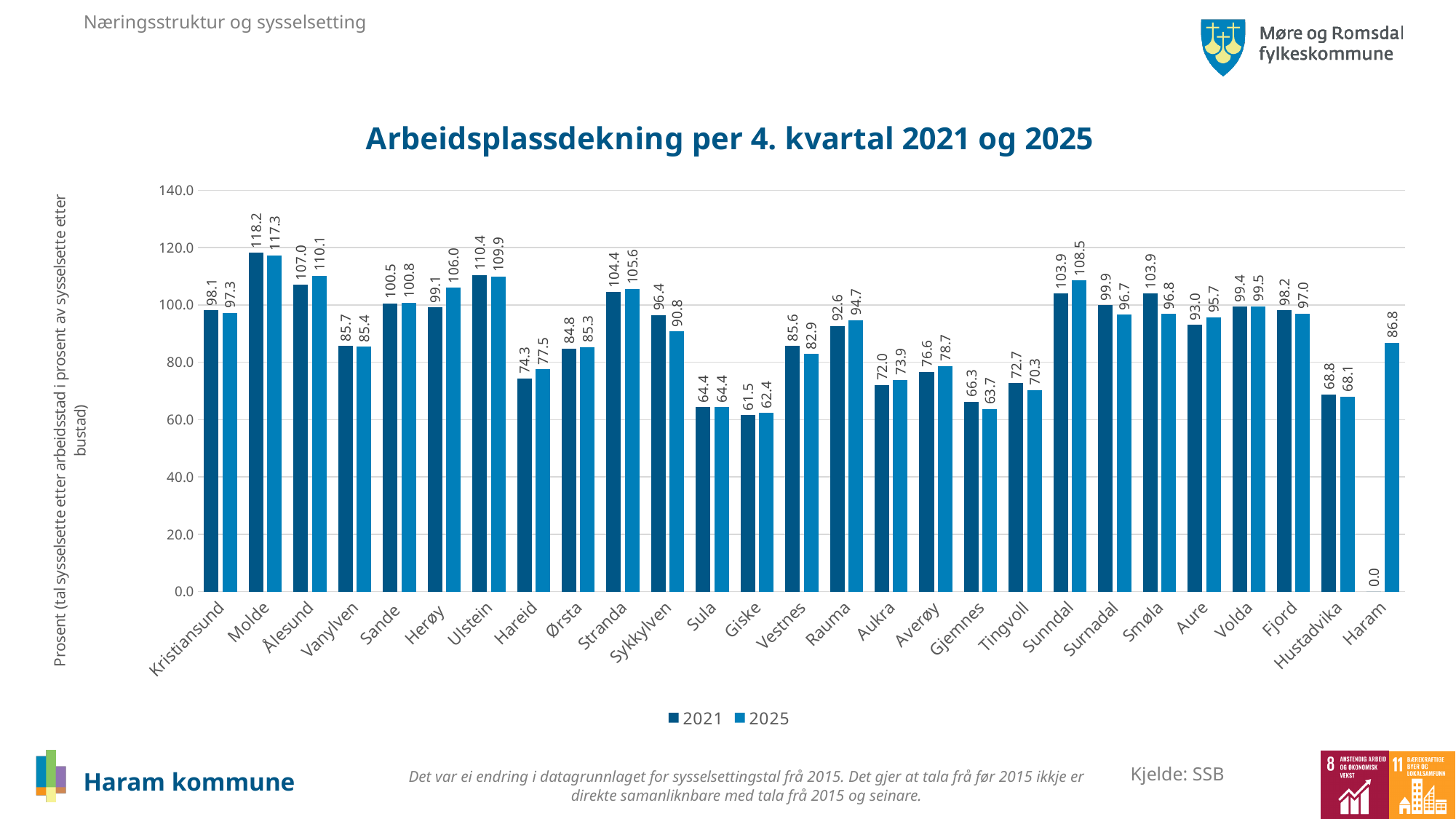
Which municipality has the highest 2025 value? Molde How many municipalities are shown on the x axis? 27 How many series does the legend list? 2 What is the 2025 value for Haram? 86.8 What is the difference between the 2025 and 2021 values for Herøy? 6.9 What is the 2021 value for Molde? 118.2 What kind of chart is shown on the slide? Bar chart What is the 2025 value for Sunndal? 108.5 Which is larger for Smøla, the 2021 value or the 2025 value? 2021 Is the 2021 value for Ulstein greater or less than 100? greater Which municipality has the lowest 2025 value? Giske What is the 2021 value for Sykkylven? 96.4